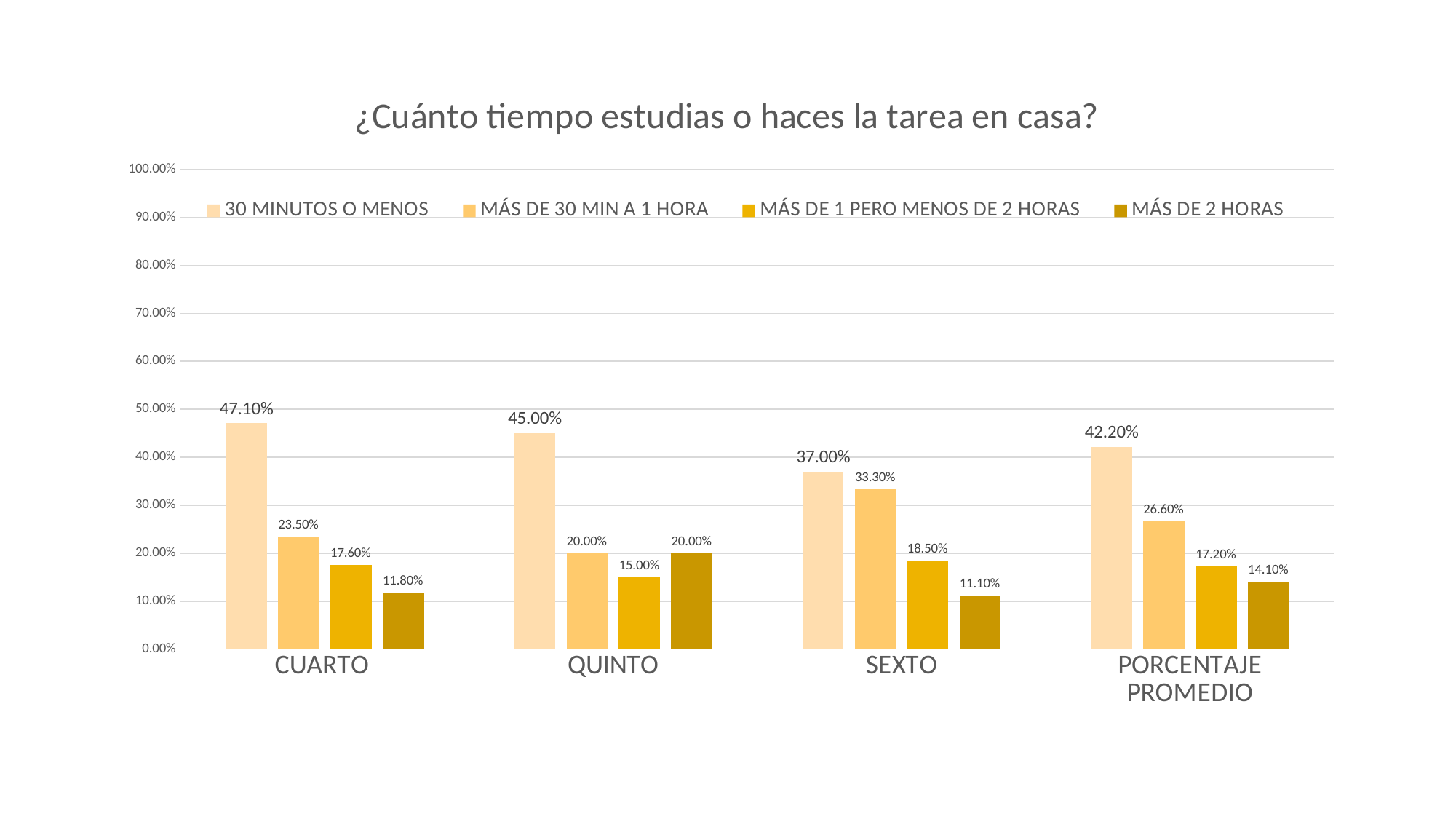
Which is larger: 'MÁS DE 30 MIN A 1 HORA' in SEXTO or 'MÁS DE 30 MIN A 1 HORA' in QUINTO? SEXTO What is the value for 'MÁS DE 2 HORAS' in the QUINTO category? 20.00% What is the value for '30 MINUTOS O MENOS' in the CUARTO category? 47.10% How many series does the legend list? 4 What is the difference between the '30 MINUTOS O MENOS' value and the 'MÁS DE 30 MIN A 1 HORA' value in the CUARTO category? 23.60% What is the value for 'MÁS DE 1 PERO MENOS DE 2 HORAS' in the PORCENTAJE PROMEDIO category? 17.20% Which category has the highest value for '30 MINUTOS O MENOS'? CUARTO How many categories are shown on the x axis? 4 What is the title of the chart? ¿Cuánto tiempo estudias o haces la tarea en casa? Which category has the lowest value for 'MÁS DE 2 HORAS'? SEXTO What kind of chart is shown on the slide? Bar chart What is the value for 'MÁS DE 30 MIN A 1 HORA' in the SEXTO category? 33.30%